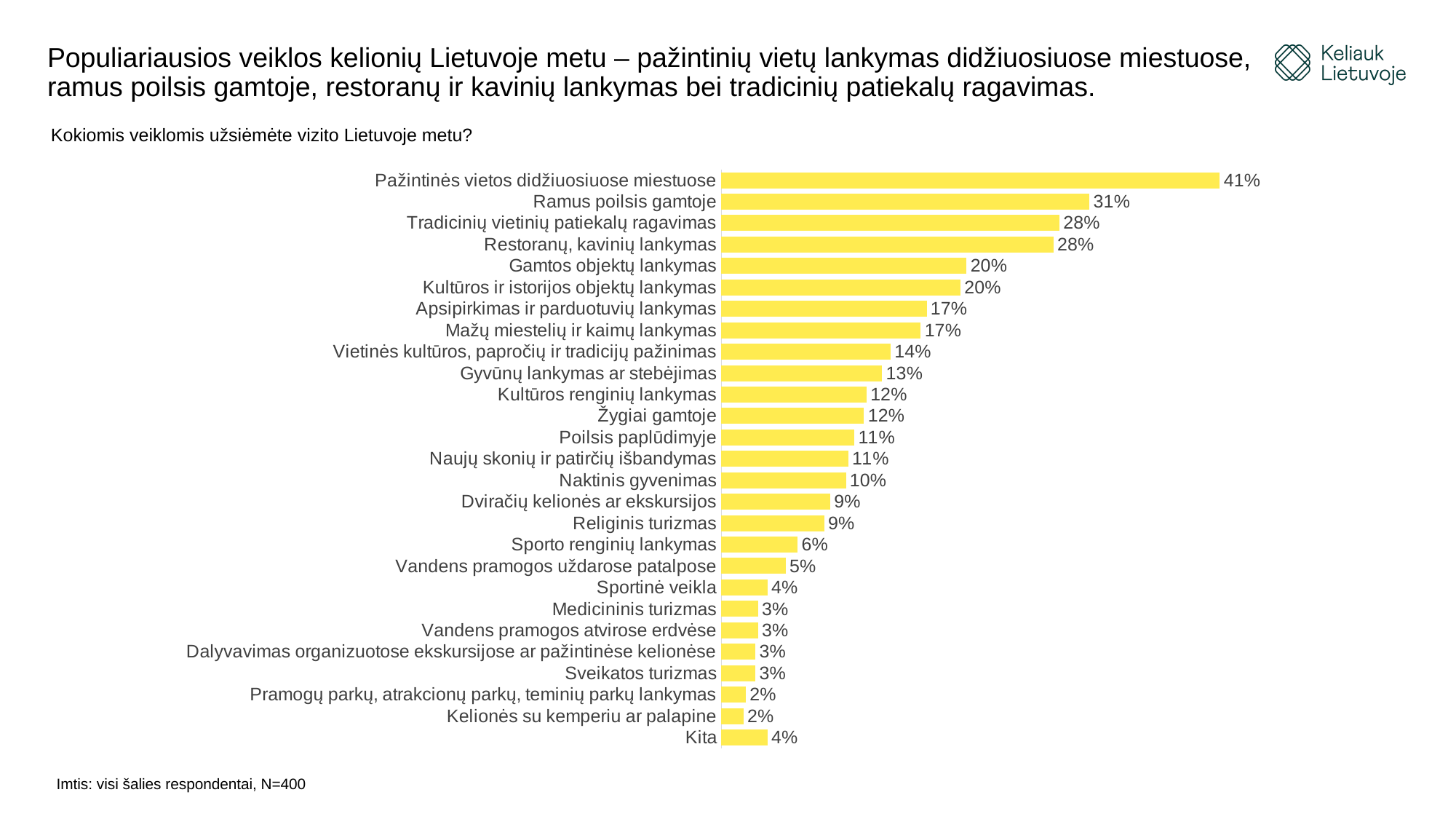
Which is larger, Gyvūnų lankymas ar stebėjimas or Religinis turizmas? Gyvūnų lankymas ar stebėjimas What is the difference between Pažintinės vietos didžiuosiuose miestuose and Ramus poilsis gamtoje? 10% What is the value for Pažintinės vietos didžiuosiuose miestuose? 41% Which is larger, Sportinė veikla or Vandens pramogos uždarose patalpose? Vandens pramogos uždarose patalpose How many categories are shown in the chart? 27 What kind of chart is shown on the slide? bar chart What question is the chart based on, as printed above it? Kokiomis veiklomis užsiėmėte vizito Lietuvoje metu? What is the value for Kita? 4% What is the value for Naktinis gyvenimas? 10% What is the value for Ramus poilsis gamtoje? 31% Which category has the highest value? Pažintinės vietos didžiuosiuose miestuose What is the difference between Gamtos objektų lankymas and Sporto renginių lankymas? 14%